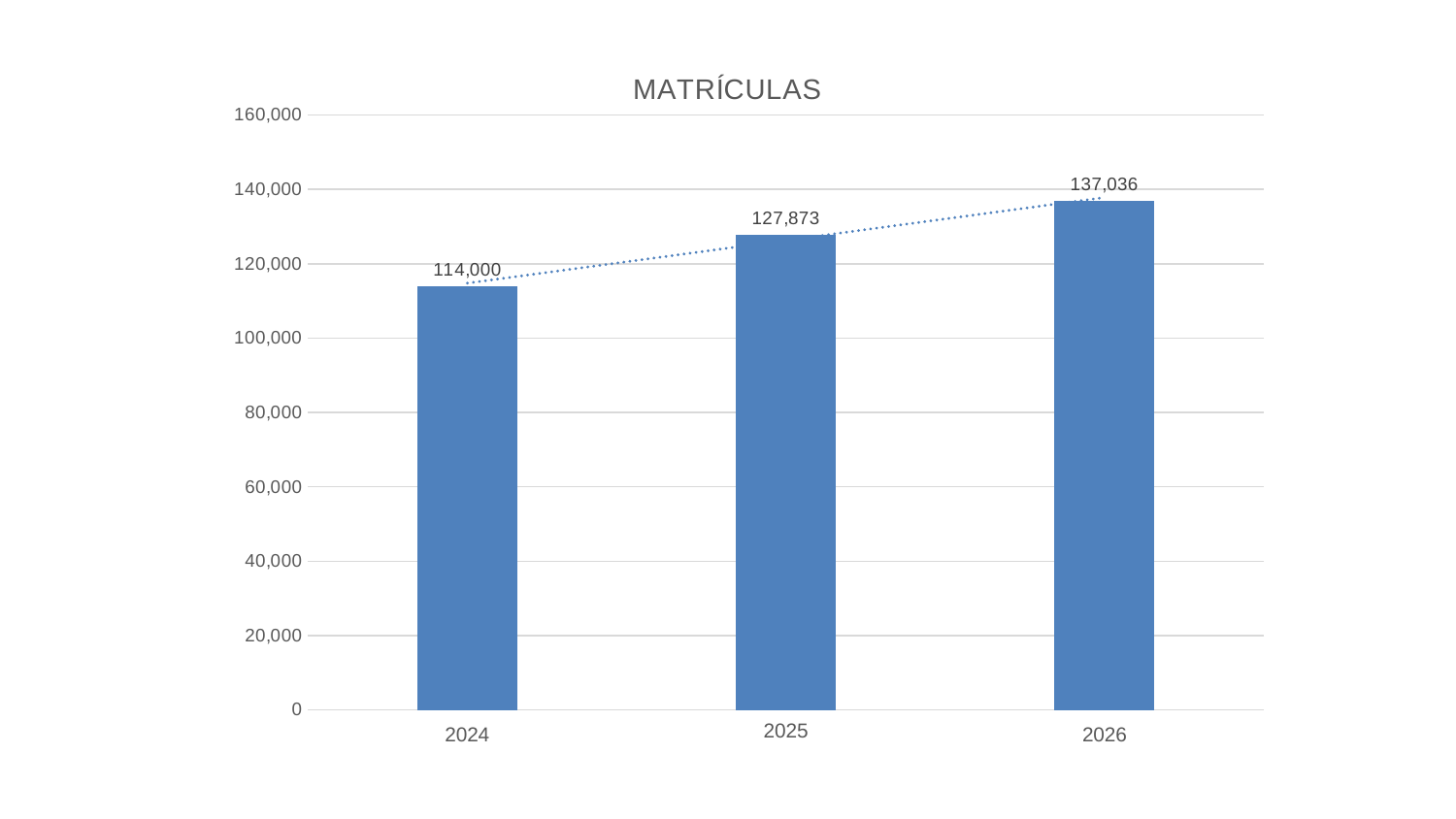
What is the value for 2026? 137,036 Which year has the lowest value? 2024 Do the values rise or fall from 2024 to 2026? rise Which year has the highest value? 2026 What is the difference between the values for 2025 and 2024? 13,873 What is the value for 2024? 114,000 What is the difference between the values for 2026 and 2024? 23,036 What kind of chart is this? bar chart What is the value for 2025? 127,873 Which is larger, the value for 2025 or the value for 2026? 2026 How many years are shown on the x axis? 3 Is the value for 2026 greater or less than 140,000? less